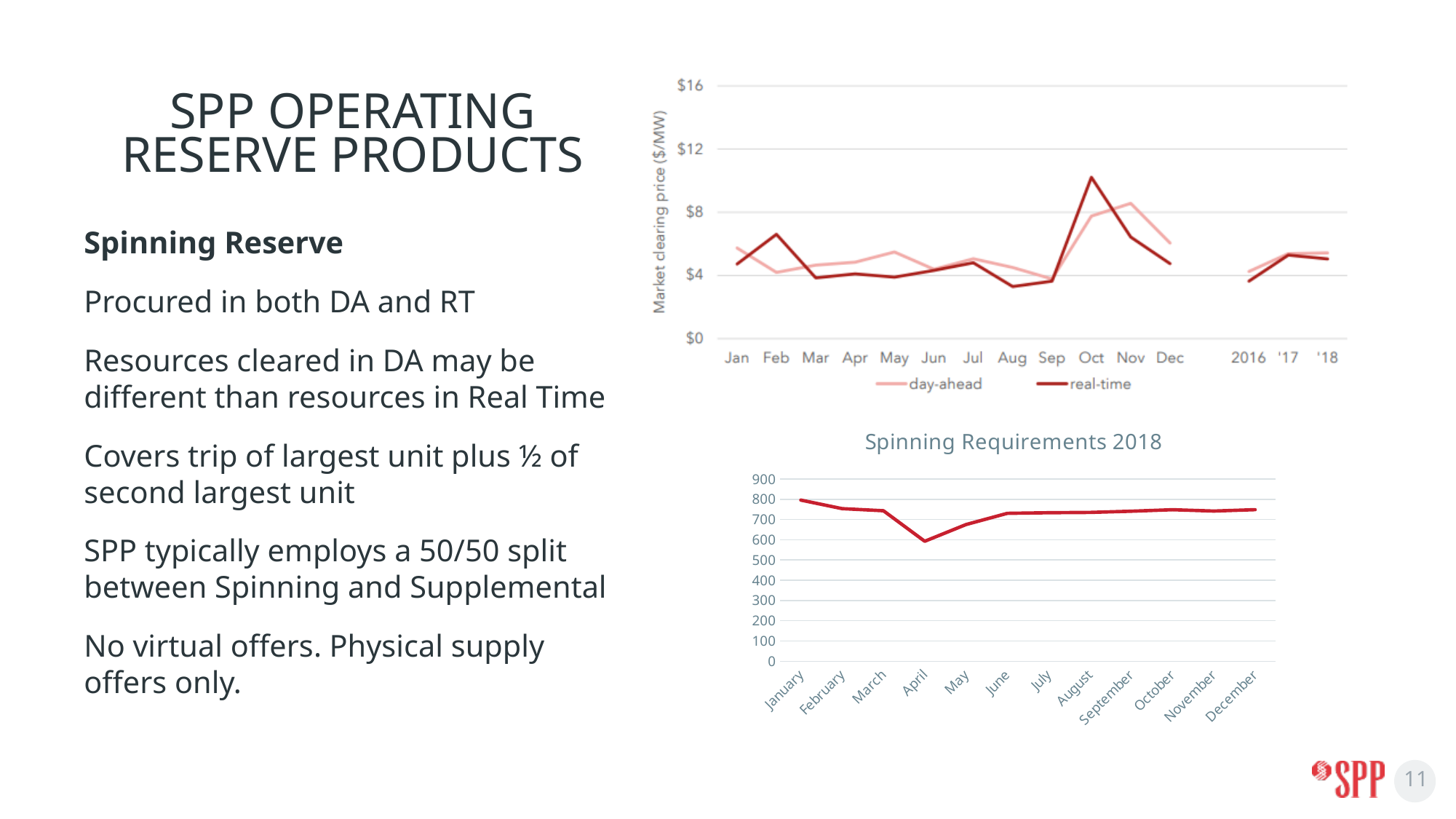
In the top-right market clearing price chart, is the real-time value for Aug greater or less than $4? less In the 'Spinning Requirements 2018' chart, which month has the highest value? January In the top-right market clearing price chart, is the real-time value for Oct greater or less than $8? greater How many series does the legend of the top-right market clearing price chart list? 2 In the 'Spinning Requirements 2018' chart, which month has the lowest value? April In the top-right market clearing price chart, in which month does the real-time series reach its highest value? Oct In the 'Spinning Requirements 2018' chart, is the value for January greater or less than 700? greater How many months are plotted on the x axis of the 'Spinning Requirements 2018' chart? 12 What kind of chart is the 'Spinning Requirements 2018' chart? line chart In the 'Spinning Requirements 2018' chart, does the value rise or fall from January to April? fall In the top-right market clearing price chart, which series is higher in Oct, day-ahead or real-time? real-time